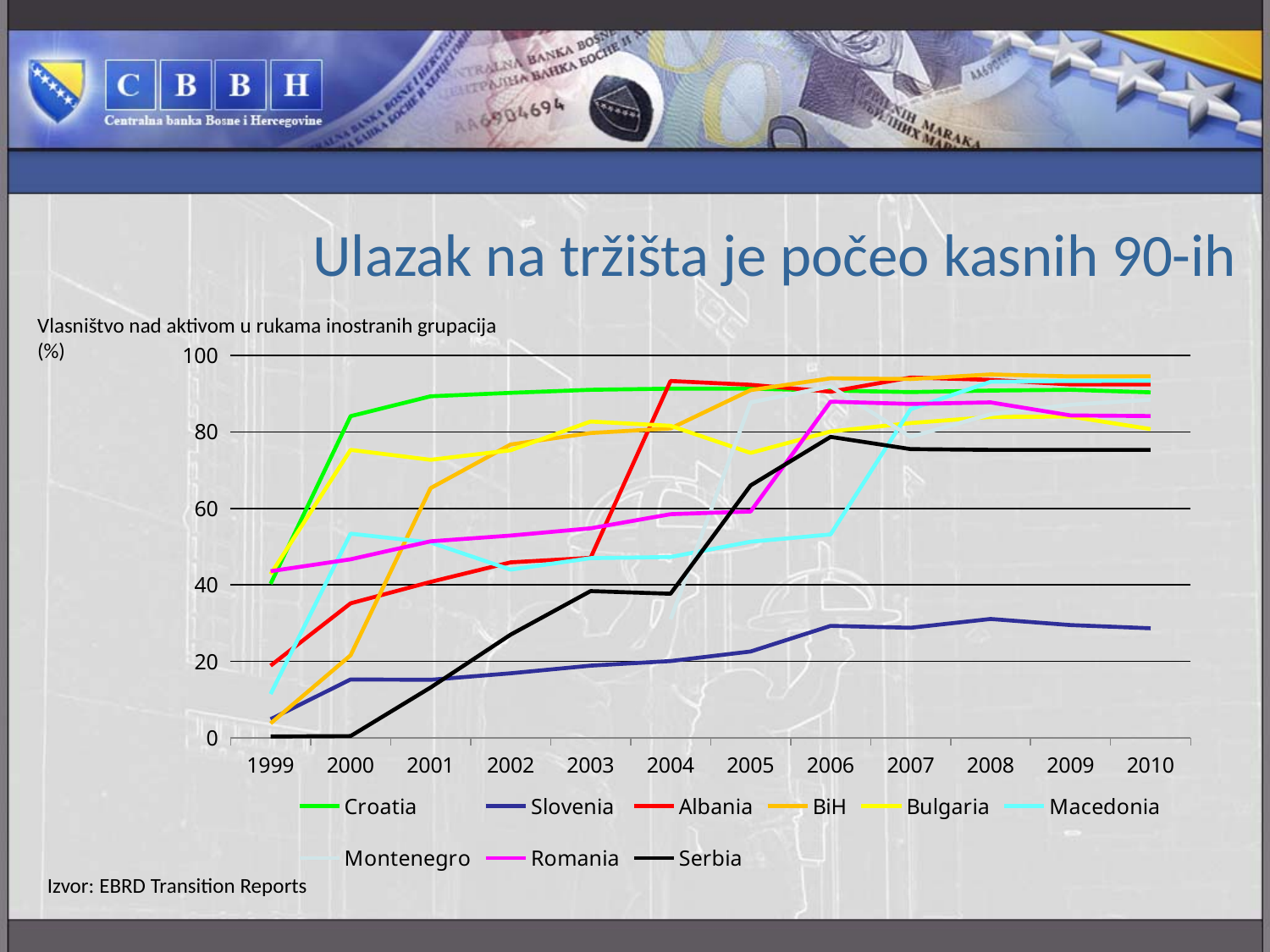
Is the value for BiH in 2000 greater or less than 40? less What kind of chart is shown on the slide? line chart Which is larger in 2003, the value for Bulgaria or the value for Macedonia? Bulgaria Does the value for Slovenia rise or fall from 1999 to 2010? rise Is the value for Croatia in 2001 greater or less than 80? greater Is the value for Serbia in 2006 greater or less than 60? greater How many series does the legend list? 9 How many years are shown on the x axis? 12 What source is cited below the chart? EBRD Transition Reports Which country has the lowest value in 2010? Slovenia